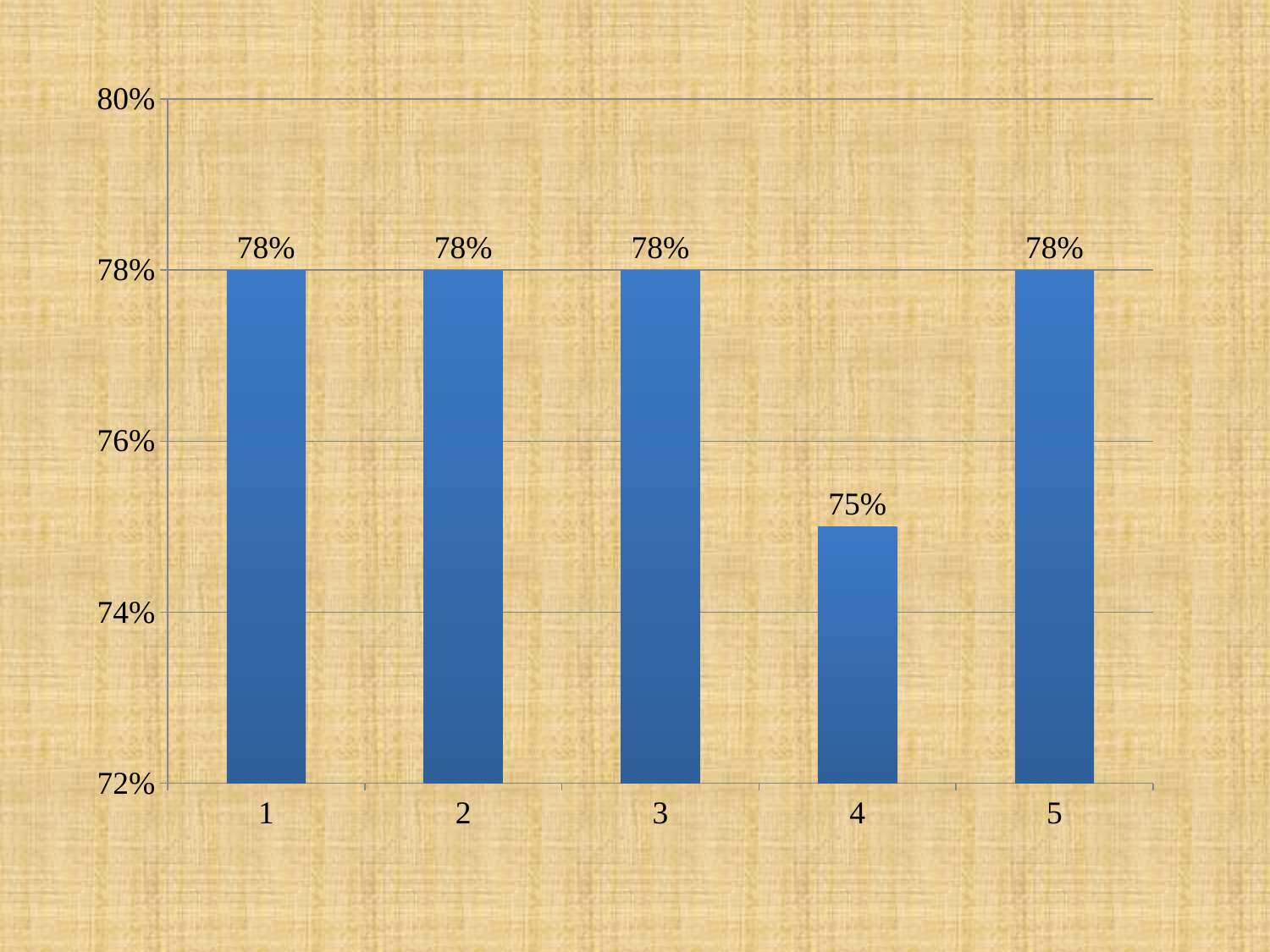
How many categories are shown on the x axis? 5 How many categories have a value of 78%? 4 Which is larger, the value for category 2 or the value for category 4? category 2 What is the difference between the values for category 3 and category 4? 3% What kind of chart is shown on the slide? bar chart What is the value for category 5? 78% Which category has the lowest value? 4 What is the value for category 4? 75% What is the value for category 1? 78% Is the value for category 2 greater or less than 76%? greater What is the highest value shown on the y axis? 80% Is the value for category 4 greater or less than 76%? less